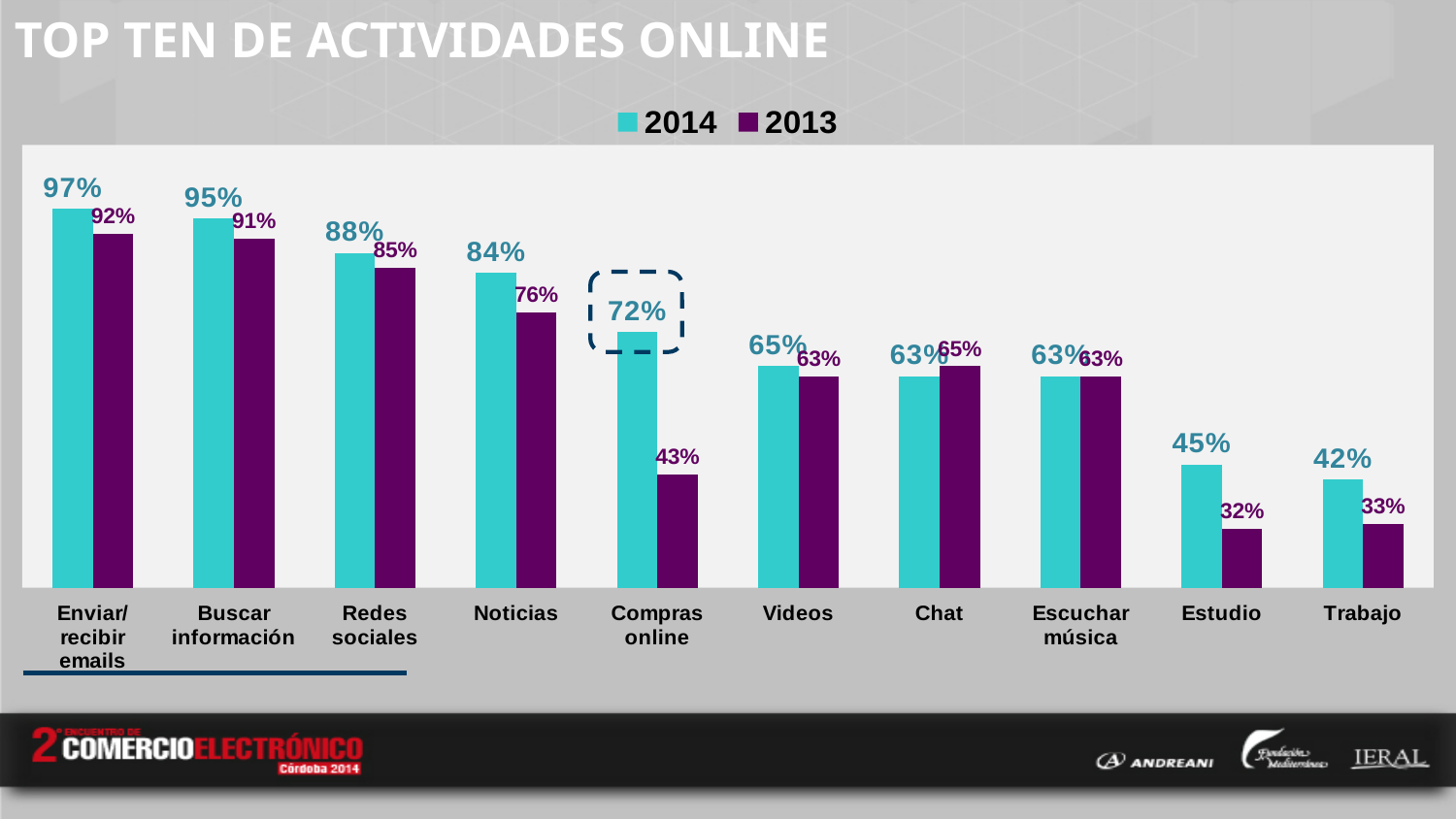
Which activity has the highest 2014 value? Enviar/recibir emails What is the 2013 value for Noticias? 76% What is the 2013 value for Estudio? 32% What is the 2014 value for Compras online? 72% Which activity has the lowest 2014 value? Trabajo What is the difference between the 2014 values for Enviar/recibir emails and Trabajo? 55% How many activities are shown on the x axis? 10 Which series is shown in purple? 2013 What is the difference between the 2014 and 2013 values for Compras online? 29% What kind of chart is shown on the slide? Bar chart How many series does the legend list? 2 For Chat, which year has the larger value, 2014 or 2013? 2013